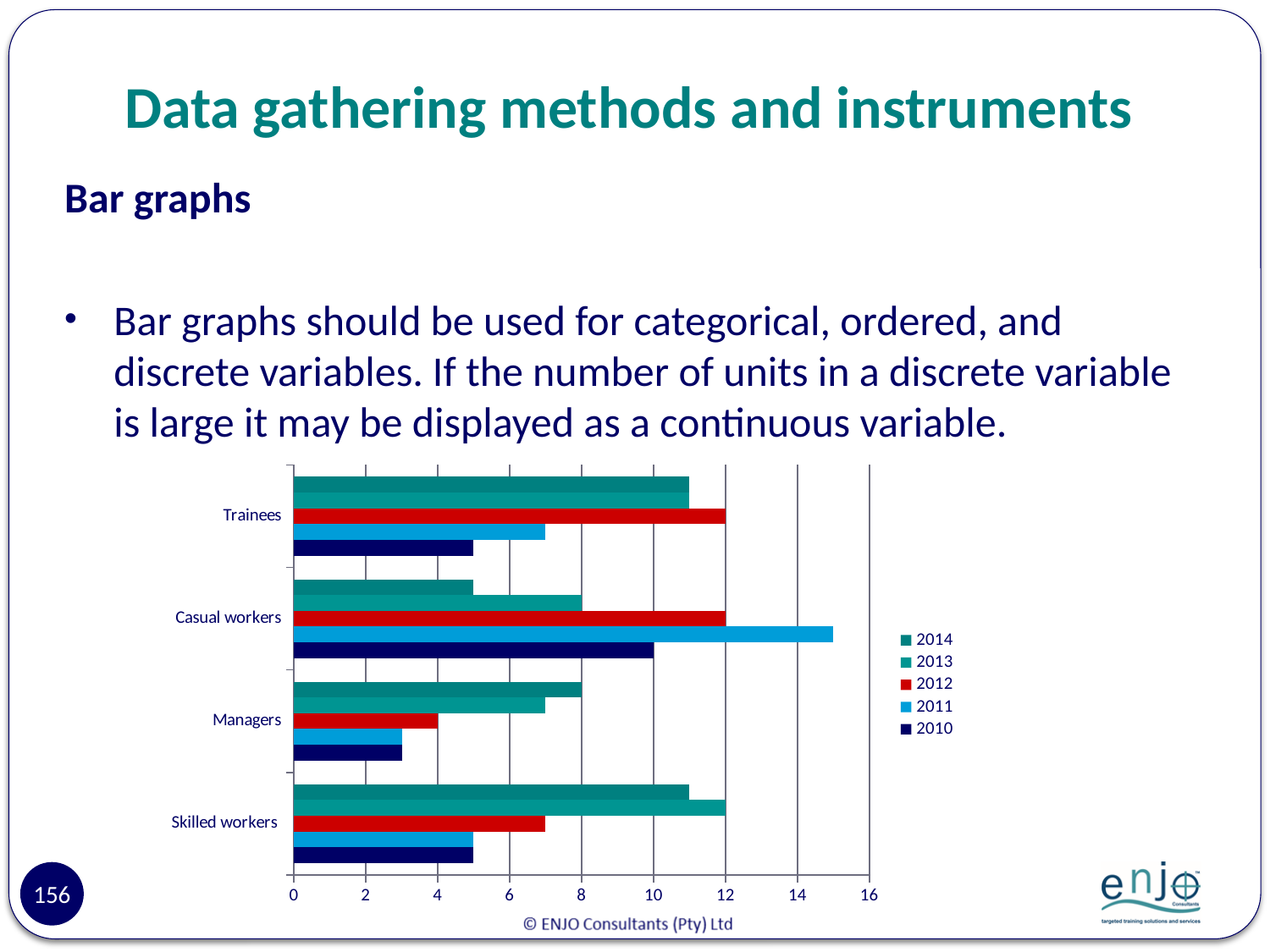
How many series does the chart's legend list? 5 What kind of chart is shown on the slide? bar chart Which category has the longest bar for the 2011 series? Casual workers How many categories are shown on the chart's vertical axis? 4 Is the 2014 value for Skilled workers greater or less than 10? greater Is the 2012 value for Managers greater or less than 6? less Which is larger: the 2011 value for Casual workers or the 2011 value for Trainees? Casual workers Which category has the shortest bar for the 2011 series? Managers For Casual workers, which series has the lowest value? 2014 What is the highest value shown on the chart's horizontal axis? 16 Is the 2011 value for Casual workers greater or less than 14? greater For Casual workers, which series has the highest value? 2011